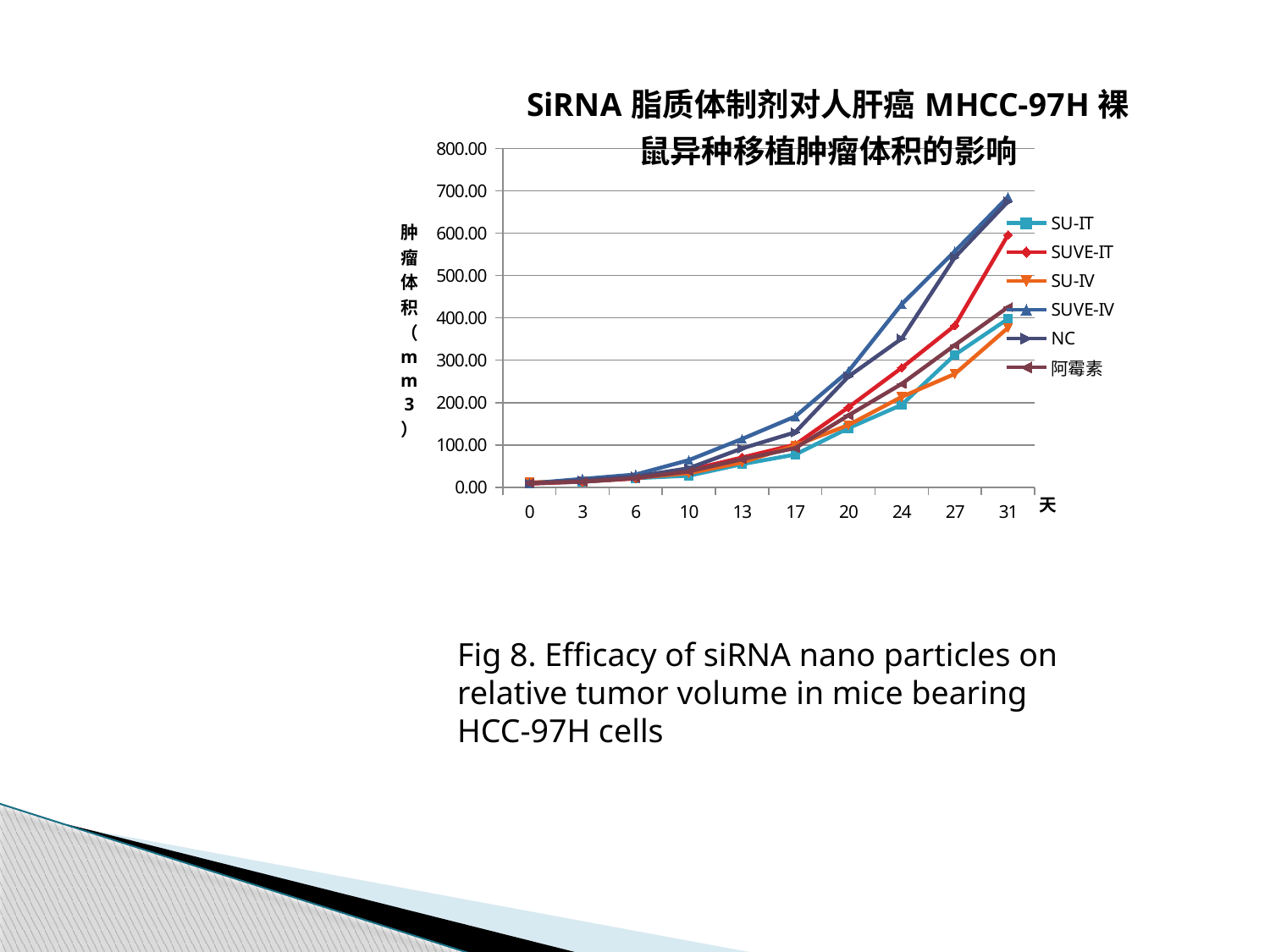
Is the value for NC at day 24 greater or less than 400? less At day 17, which is larger: NC or SU-IT? NC Is the value for SUVE-IV at day 31 greater or less than 600? greater At day 24, which series has the highest value? SUVE-IV How many series does the legend list? 6 At day 31, which is larger: SUVE-IT or SU-IV? SUVE-IT What kind of chart is shown on the slide? line chart What is the label on the x axis of the chart? 天 Is the value for SU-IV at day 27 greater or less than 300? less How many time points are plotted along the x axis? 10 Do the values for SUVE-IV rise or fall from day 0 to day 31? rise